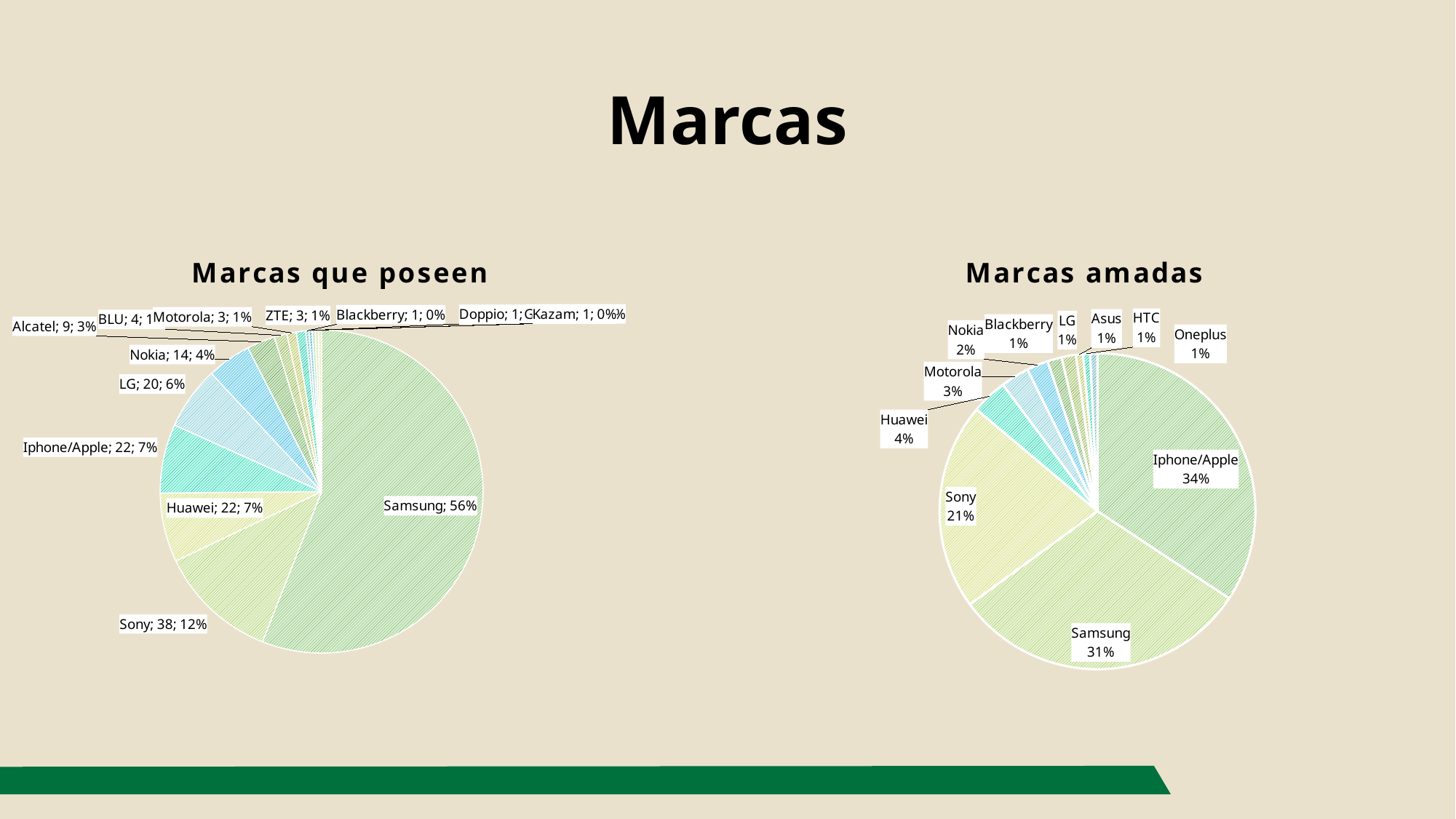
In the 'Marcas que poseen' chart, what share does Samsung have? 56% In the 'Marcas que poseen' chart, which has the larger count, LG or Alcatel? LG In the 'Marcas que poseen' chart, what percentage is shown for LG? 6% In the 'Marcas que poseen' chart, how many respondents own a Sony phone? 38 In the 'Marcas amadas' chart, what is the difference in percentage points between Samsung and Huawei? 27 In the 'Marcas amadas' chart, how many brands are shown? 11 What type of chart is used for 'Marcas amadas'? Pie chart In the 'Marcas amadas' chart, what percentage is shown for Sony? 21% In the 'Marcas que poseen' chart, what is the difference in count between Sony and Nokia? 24 In the 'Marcas que poseen' chart, which brand has the largest slice? Samsung In the 'Marcas amadas' chart, what share does Iphone/Apple have? 34% In the 'Marcas amadas' chart, which brand has the largest share? Iphone/Apple